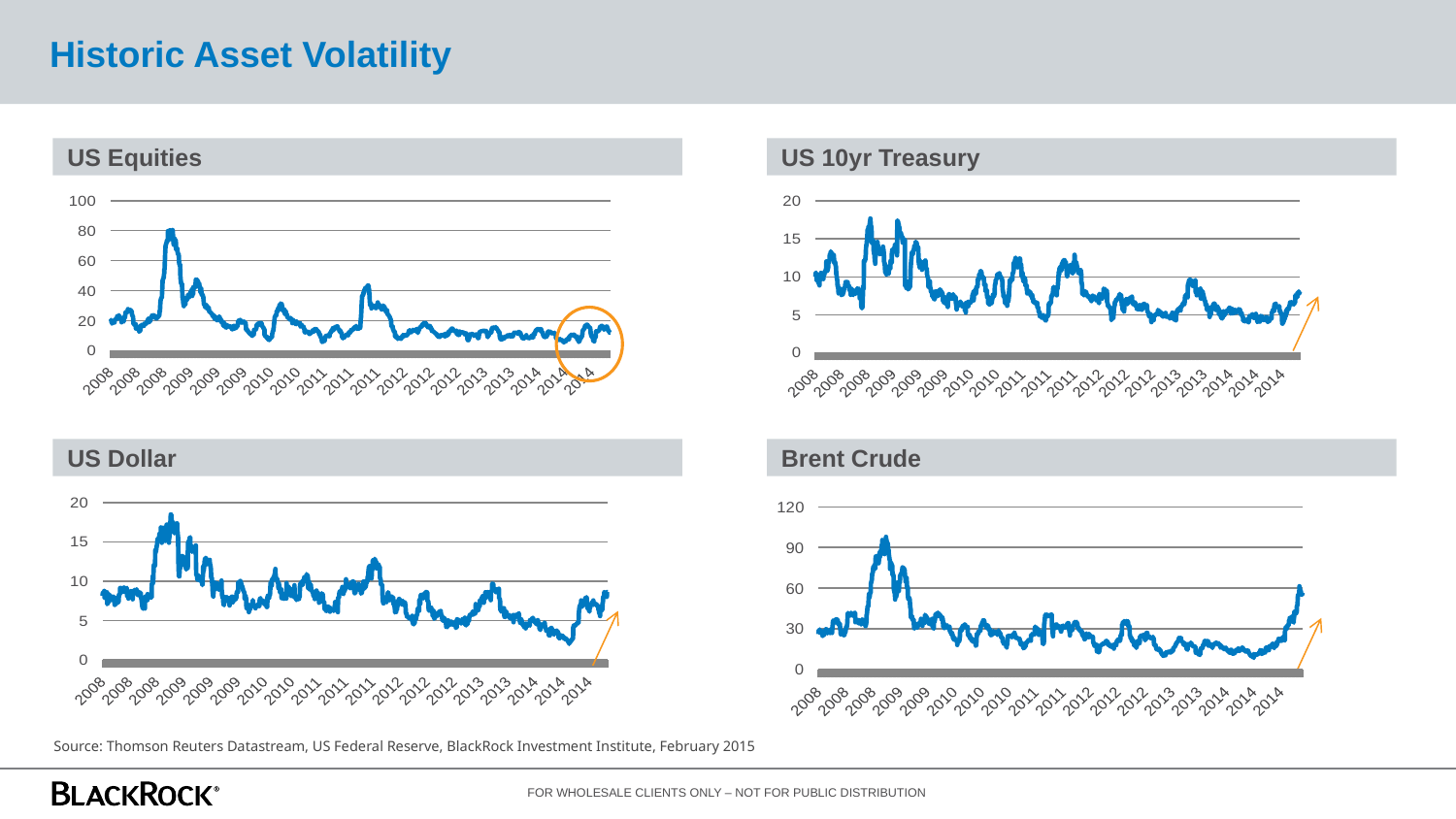
What kind of chart is the US Equities chart? line chart On the Brent Crude chart, does the line rise or fall at the far right end (late 2014)? rise On the US 10yr Treasury chart, is the highest value reached greater or less than 15? greater On the US Dollar chart, is the highest value reached greater or less than 15? greater How many charts are shown on the slide? 4 Which chart on the slide has an orange circle drawn around its most recent data? US Equities On the US Equities chart, is the peak value reached in 2008 greater or less than 60? greater What is the highest value shown on the vertical axis of the Brent Crude chart? 120 On the US Equities chart, does the line rise or fall from its 2008 peak into 2009? fall